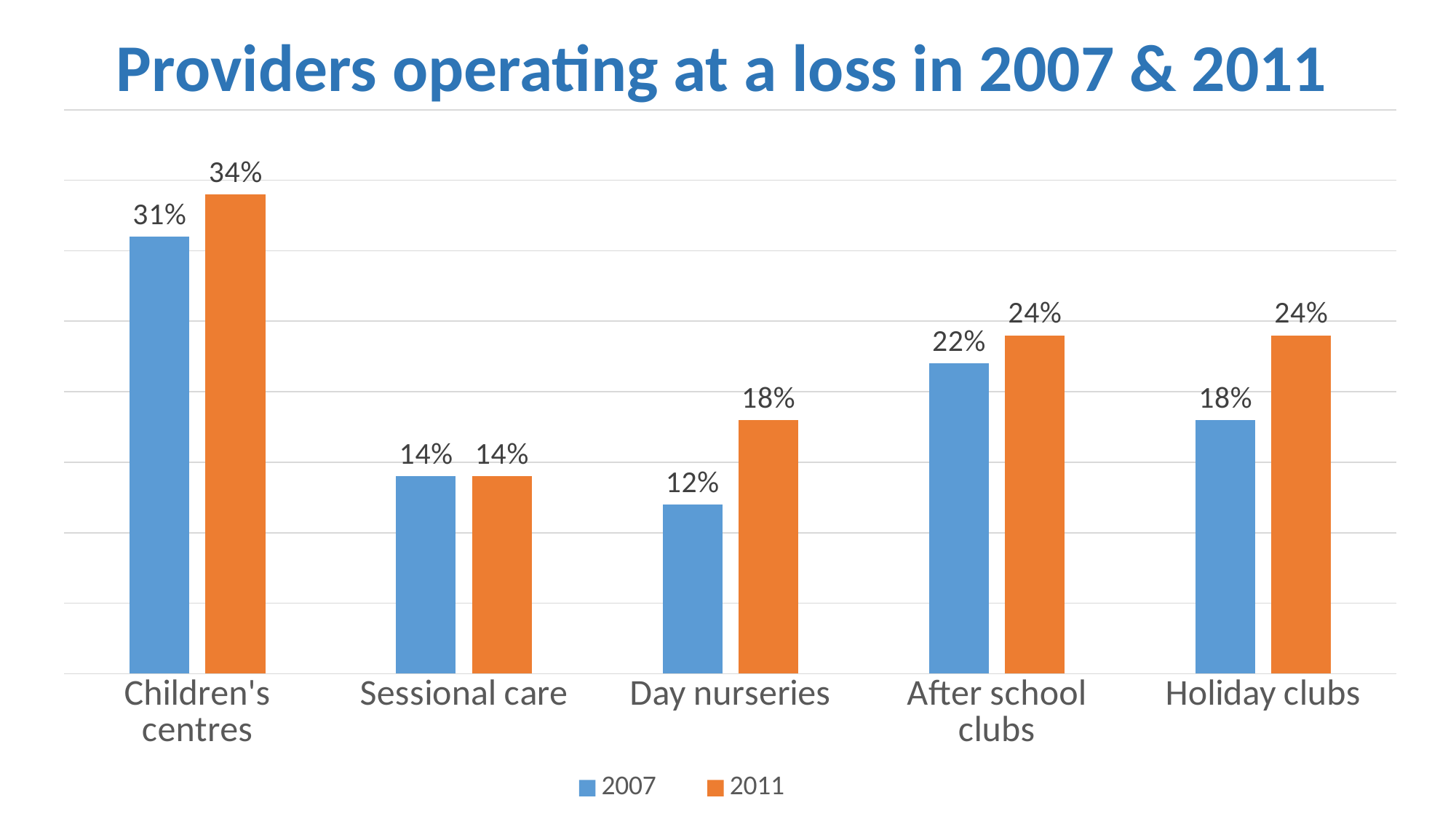
Which category has the lowest value in 2007? Day nurseries Which category has the highest value in 2011? Children's centres What percentage of children's centres were operating at a loss in 2011? 34% What is the value for holiday clubs in 2007? 18% What is the difference between the 2011 and 2007 values for day nurseries? 6% What is the title of the chart? Providers operating at a loss in 2007 & 2011 What kind of chart is shown on the slide? Bar chart How many provider categories are shown on the x axis? 5 Which is larger for after school clubs: the 2007 value or the 2011 value? 2011 What is the value for day nurseries in 2007? 12% What is the difference between the 2011 and 2007 values for children's centres? 3% How many series does the legend list? 2